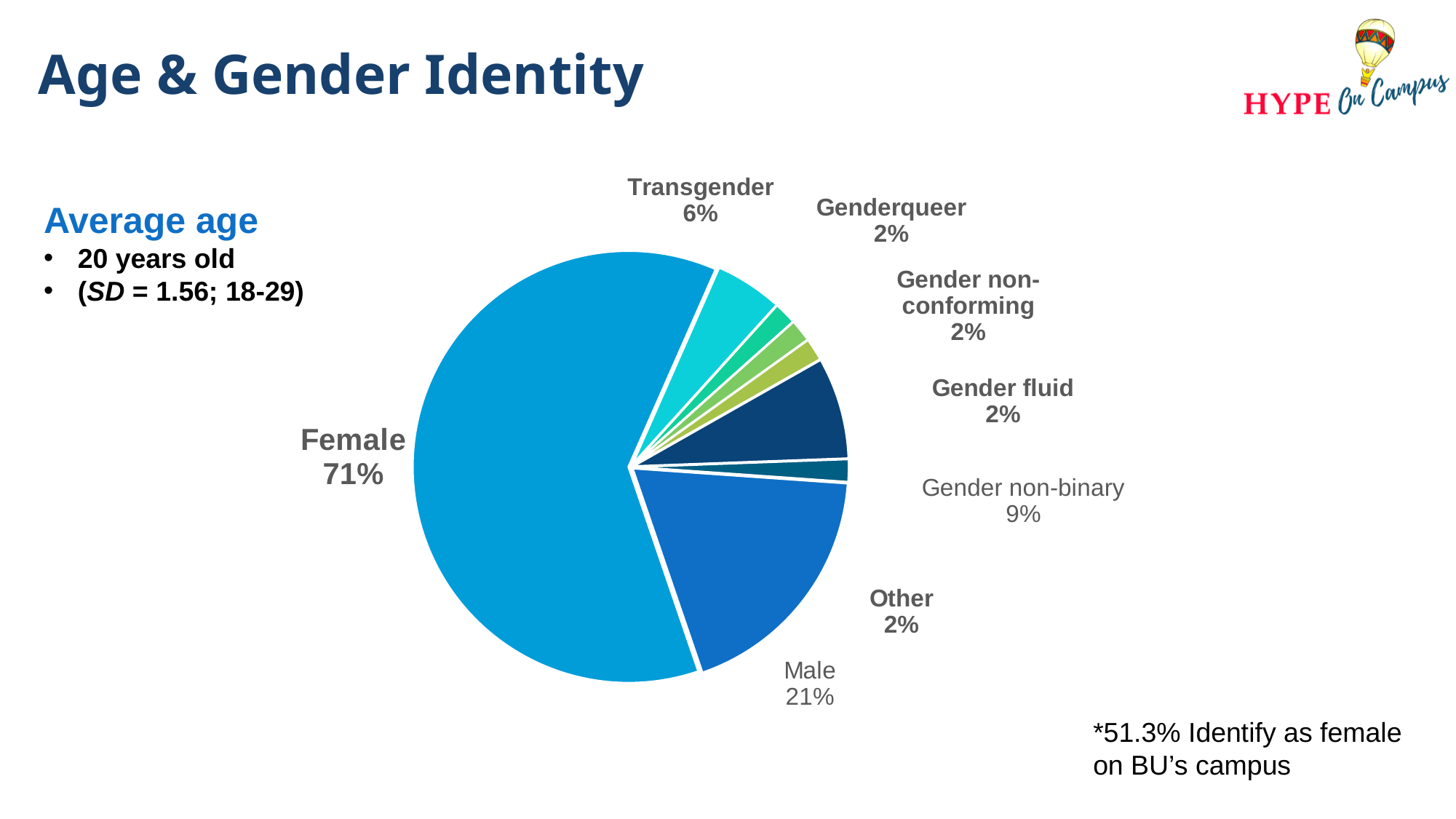
What percentage is shown for Gender fluid? 2% What percentage is shown for Gender non-binary? 9% What is the difference in percentage points between Female and Male? 50 What percentage is shown for Male? 21% What share of the pie is labelled Female? 71% What kind of chart is shown on the slide? Pie chart What percentage is shown for Transgender? 6% What is the title of the slide containing the pie chart? Age & Gender Identity Which category has the largest slice of the pie? Female Which is larger, the Transgender slice or the Gender non-binary slice? Gender non-binary How many slices does the pie chart have? 8 What is the difference in percentage points between Male and Gender non-binary? 12